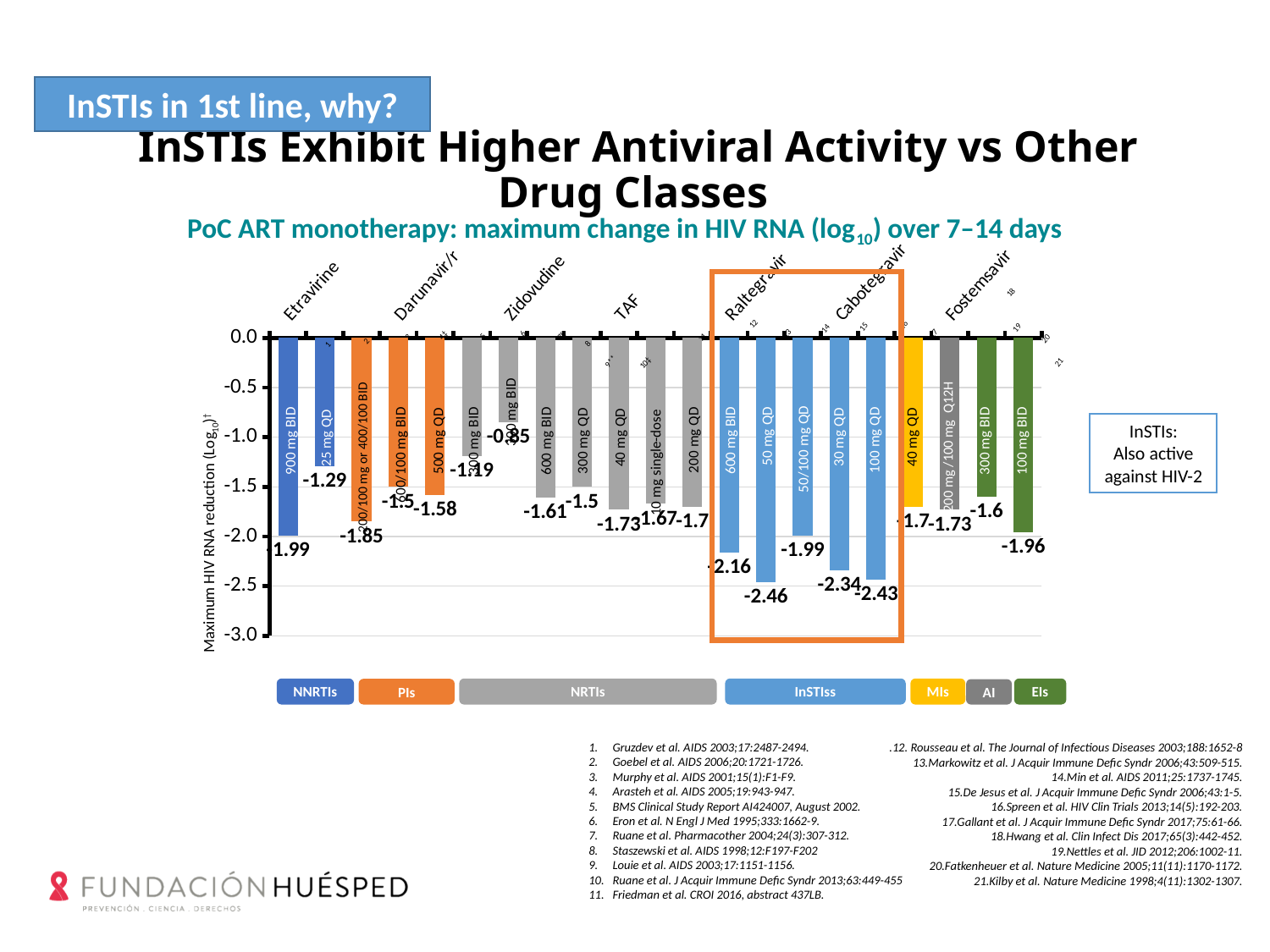
What is the maximum HIV RNA reduction shown for TAF 40 mg QD? -1.73 What is the maximum HIV RNA reduction shown for cabotegravir 30 mg QD? -2.34 How many drug classes are listed in the legend below the chart? 7 Which shows a larger HIV RNA reduction: cabotegravir 30 mg QD or zidovudine 600 mg BID? Cabotegravir 30 mg QD What type of chart is shown on the slide? Bar chart What is the maximum HIV RNA reduction shown for etravirine 900 mg BID? -1.99 Which drug class is highlighted by the orange box on the chart? InSTIs What is the maximum HIV RNA reduction shown for raltegravir 600 mg BID? -2.16 What is the largest HIV RNA reduction value labelled on the chart? -2.46 What is the smallest HIV RNA reduction value labelled on the chart? -0.85 By how much does the reduction for raltegravir 600 mg BID (-2.16) exceed that for etravirine 900 mg BID (-1.99)? 0.17